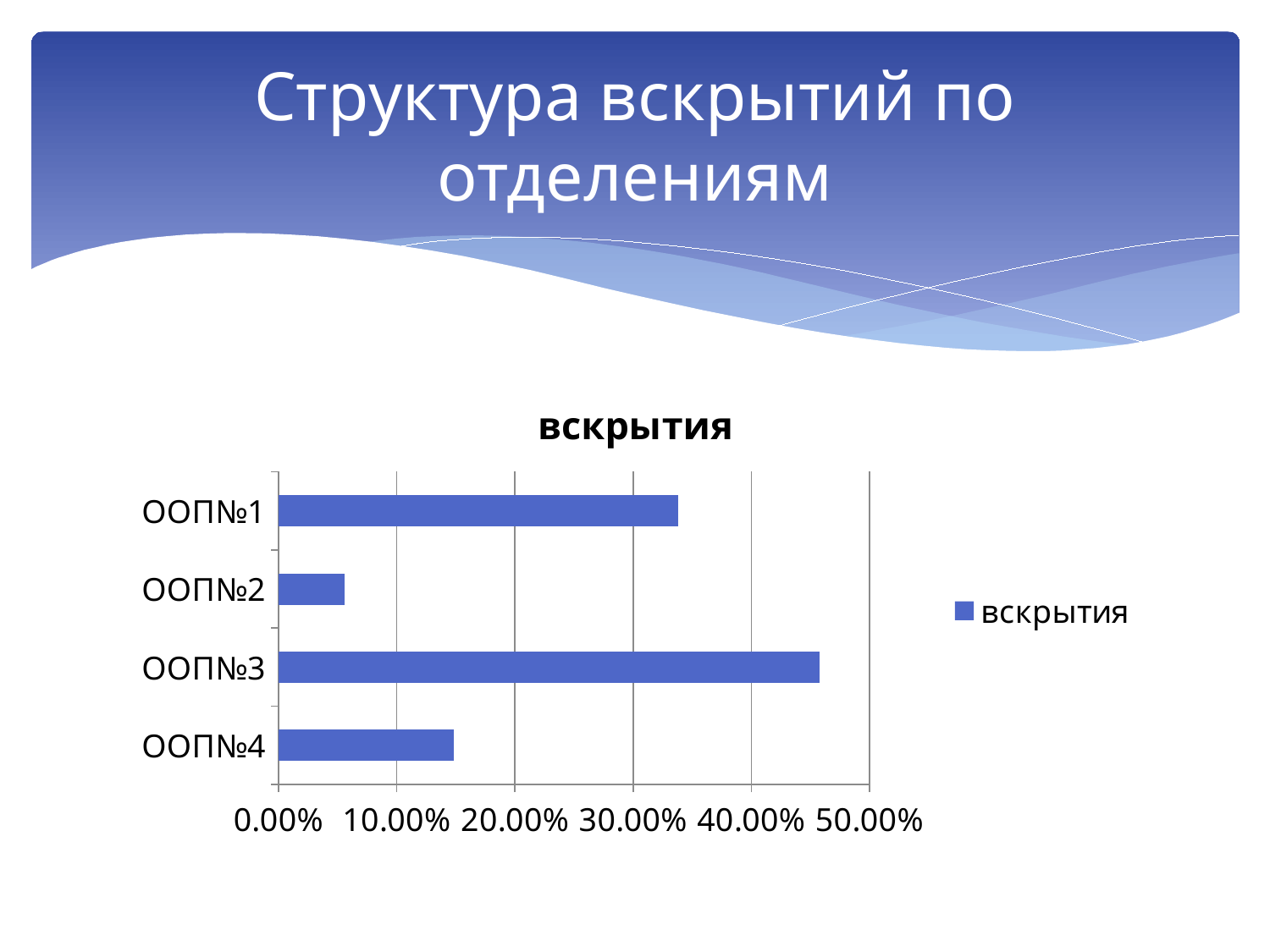
Which category has the lowest value? ООП№2 Which is larger, the value for ООП№1 or the value for ООП№4? ООП№1 What is the title of the chart? вскрытия What is the name of the series shown in the legend? вскрытия What kind of chart is shown on the slide? bar chart Is the value for ООП№2 greater or less than 10.00%? less Is the value for ООП№3 greater or less than 40.00%? greater How many series does the legend list? 1 Which is larger, the value for ООП№2 or the value for ООП№4? ООП№4 Which category has the highest value? ООП№3 How many categories are plotted in the chart? 4 Is the value for ООП№1 greater or less than 30.00%? greater